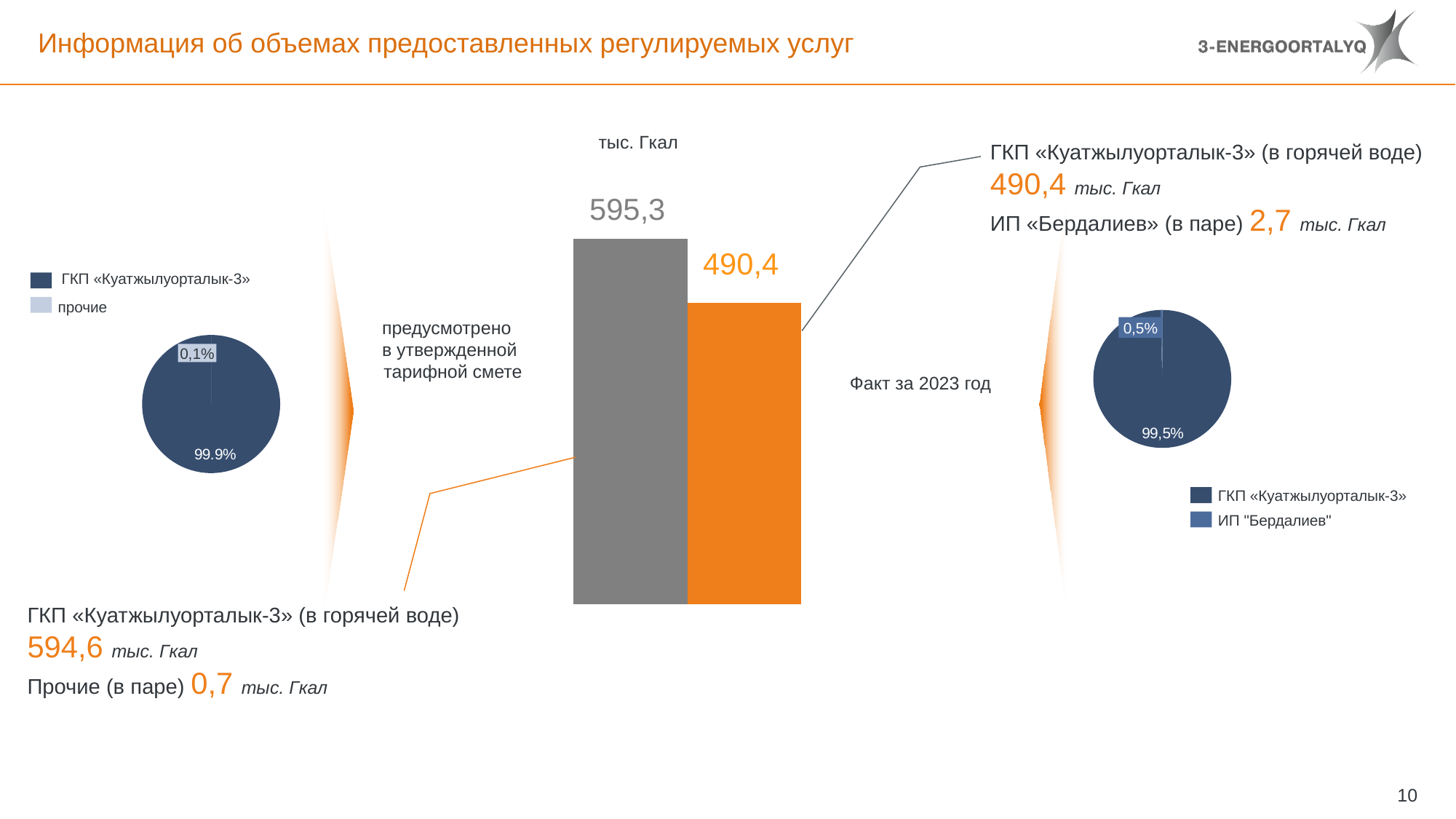
On the left pie chart, what share does 'прочие' have? 0,1% On the right pie chart, what share does 'ГКП «Куатжылуорталык-3»' have? 99,5% On the central bar chart, what is the difference between the planned value (595,3) and the actual value for 2023 (490,4)? 104,9 What unit is shown above the central bar chart? тыс. Гкал What type of chart is the central chart with the grey and orange bars? bar chart On the left pie chart, what share does 'ГКП «Куатжылуорталык-3»' have? 99.9% On the central bar chart, what is the value of the bar for 'предусмотрено в утвержденной тарифной смете'? 595,3 How many entries does the legend of the right pie chart list? 2 On the central bar chart, what is the value of the bar for 'Факт за 2023 год'? 490,4 On the central bar chart, which bar is higher: 'предусмотрено в утвержденной тарифной смете' or 'Факт за 2023 год'? предусмотрено в утвержденной тарифной смете How many bars are shown on the central bar chart? 2